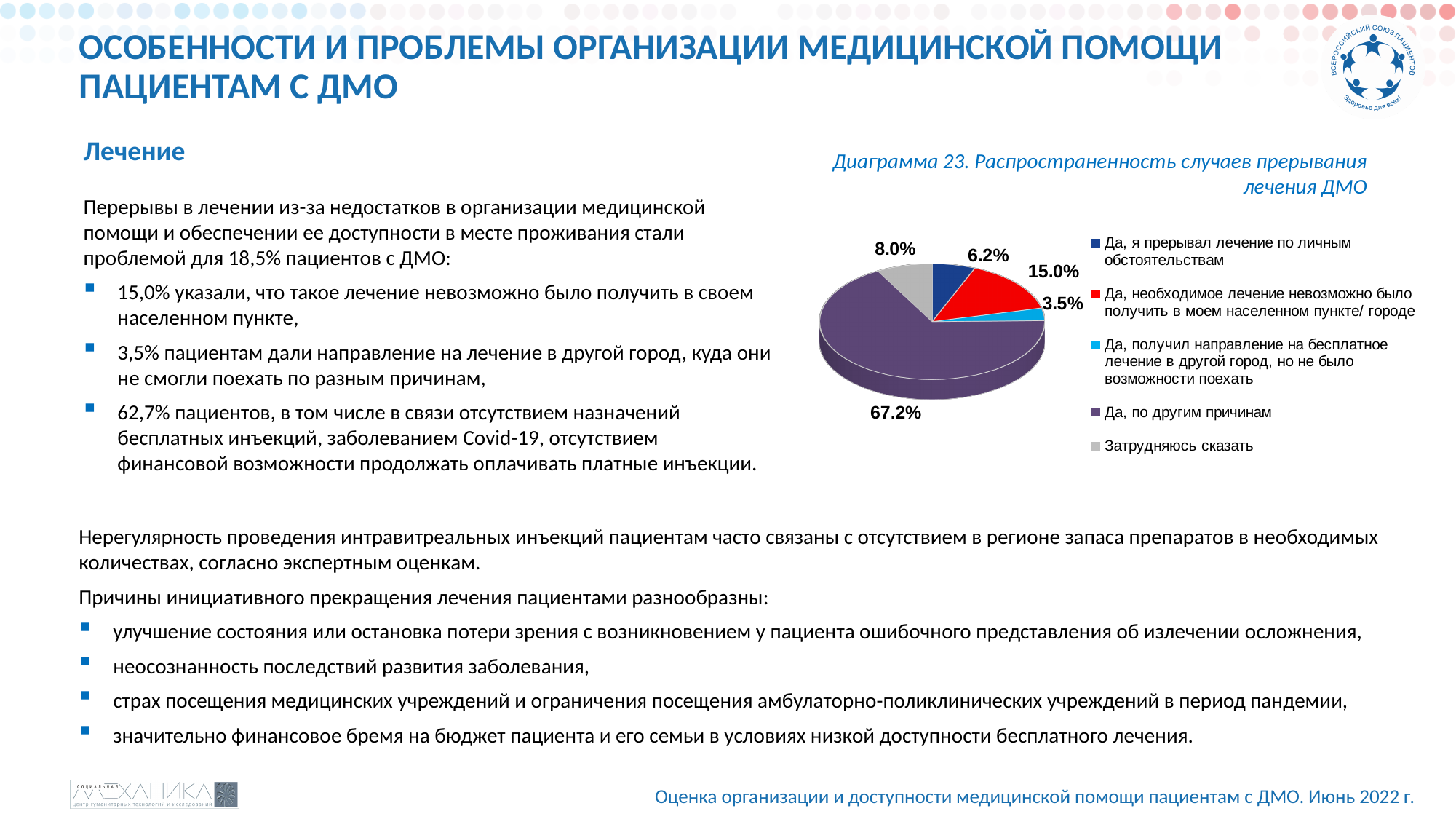
Какой тип диаграммы используется в «Диаграмме 23. Распространенность случаев прерывания лечения ДМО»? Круговая диаграмма Сколько категорий (секторов) показано на диаграмме? 5 Какая доля приходится на категорию «Да, необходимое лечение невозможно было получить в моем населенном пункте/ городе»? 15.0% Какая доля приходится на категорию «Да, по другим причинам»? 67.2% Какая доля приходится на категорию «Да, я прерывал лечение по личным обстоятельствам»? 6.2% Какая доля приходится на категорию «Затрудняюсь сказать»? 8.0% Какая категория имеет наибольшую долю на диаграмме? Да, по другим причинам Какая доля приходится на категорию «Да, получил направление на бесплатное лечение в другой город, но не было возможности поехать»? 3.5% Что больше: доля «Затрудняюсь сказать» или доля «Да, я прерывал лечение по личным обстоятельствам»? Затрудняюсь сказать Каким цветом на диаграмме обозначена категория «Да, по другим причинам»? Фиолетовым На сколько процентных пунктов доля «Да, необходимое лечение невозможно было получить в моем населенном пункте/ городе» больше доли «Затрудняюсь сказать»? 7.0 Какая категория имеет наименьшую долю на диаграмме? Да, получил направление на бесплатное лечение в другой город, но не было возможности поехать